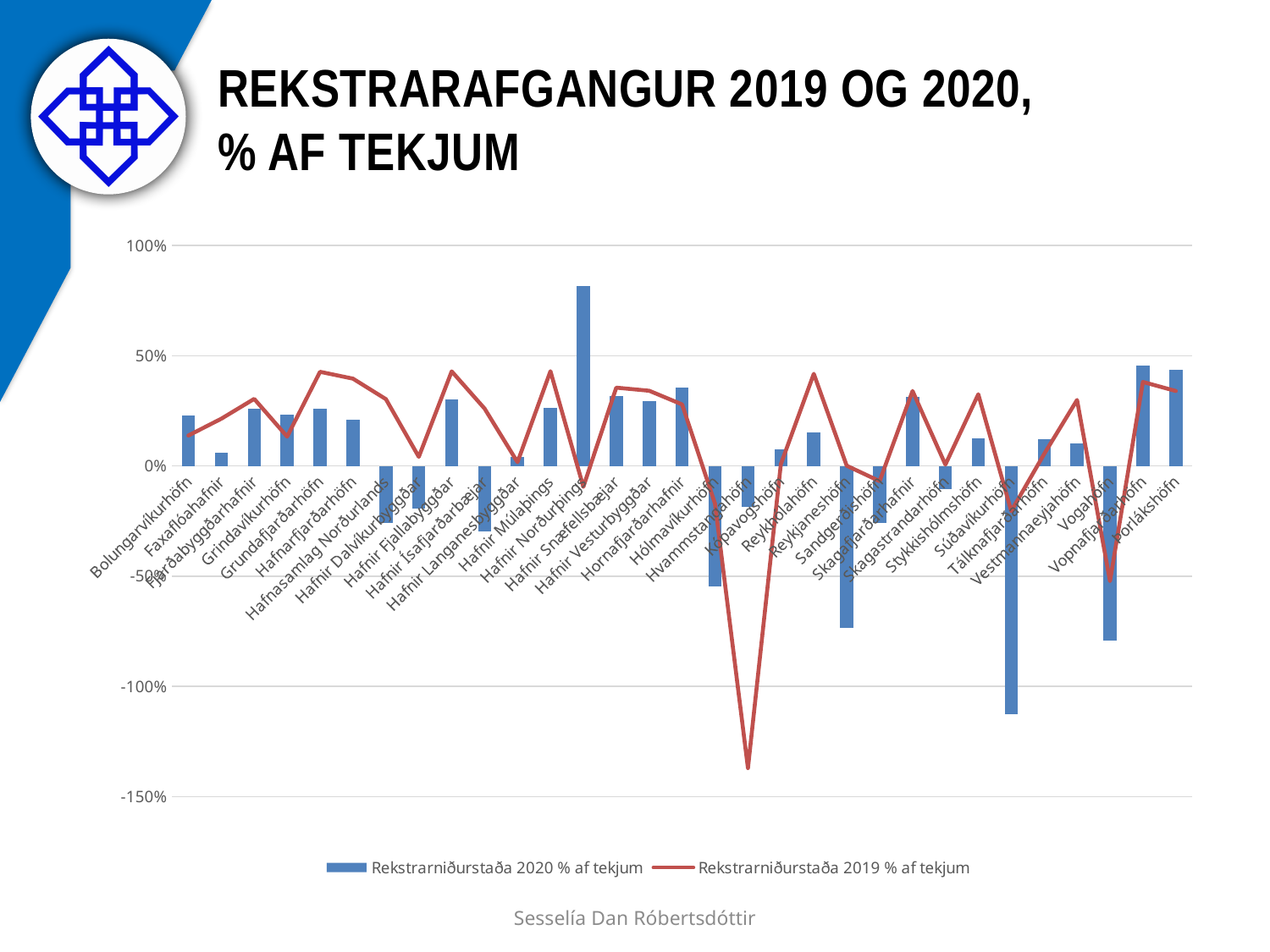
Is the 2020 value for Vogahöfn greater or less than -50%? less Which series is drawn as a red line? Rekstrarniðurstaða 2019 % af tekjum Which harbour has the highest bar for Rekstrarniðurstaða 2020 % af tekjum? Hafnir Norðurþings Which harbour has the lowest value on the Rekstrarniðurstaða 2019 % af tekjum line? Hvammstangahöfn Is the 2020 value for Hafnir Norðurþings greater or less than 50%? greater Is the 2019 value for Kópavogshöfn greater or less than -100%? greater How many series does the legend list? 2 Which has the larger 2020 bar, Hafnir Norðurþings or Þorlákshöfn? Hafnir Norðurþings Which harbour has the lowest bar for Rekstrarniðurstaða 2020 % af tekjum? Súðavíkurhöfn How many harbours (categories) are shown on the x axis? 31 What kind of chart is shown on the slide? A combined bar and line chart